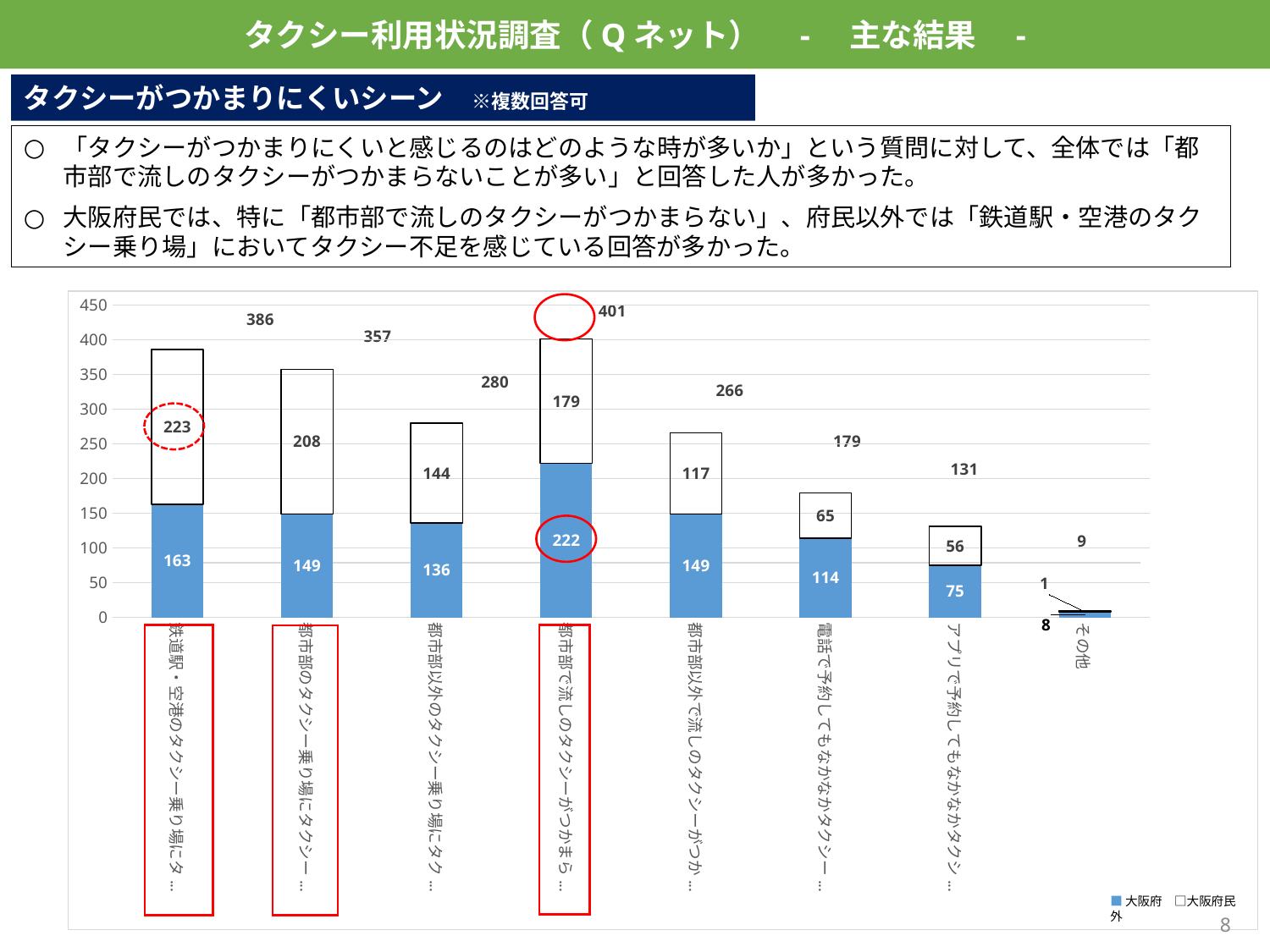
What is the 大阪府外 value for the category その他? 8 How many categories are plotted along the x axis? 8 Which is larger for 電話で予約してもなかなかタクシー…: the 大阪府外 value or the 大阪府民 value? 大阪府外 How many series does the legend list? 2 What is the 大阪府民 value for the category 都市部で流しのタクシーがつかまら…? 179 What is the difference between the 大阪府民 value and the 大阪府外 value for 鉄道駅・空港のタクシー乗り場にタ…? 60 What is the 大阪府外 value for the category 鉄道駅・空港のタクシー乗り場にタ…? 163 What is the total of the stacked bar for 都市部で流しのタクシーがつかまら…? 401 Which series is shown in blue in the legend? 大阪府外 Which category has the lowest stacked total? その他 What kind of chart is shown on the slide? stacked bar chart Which category has the highest stacked total? 都市部で流しのタクシーがつかまら…